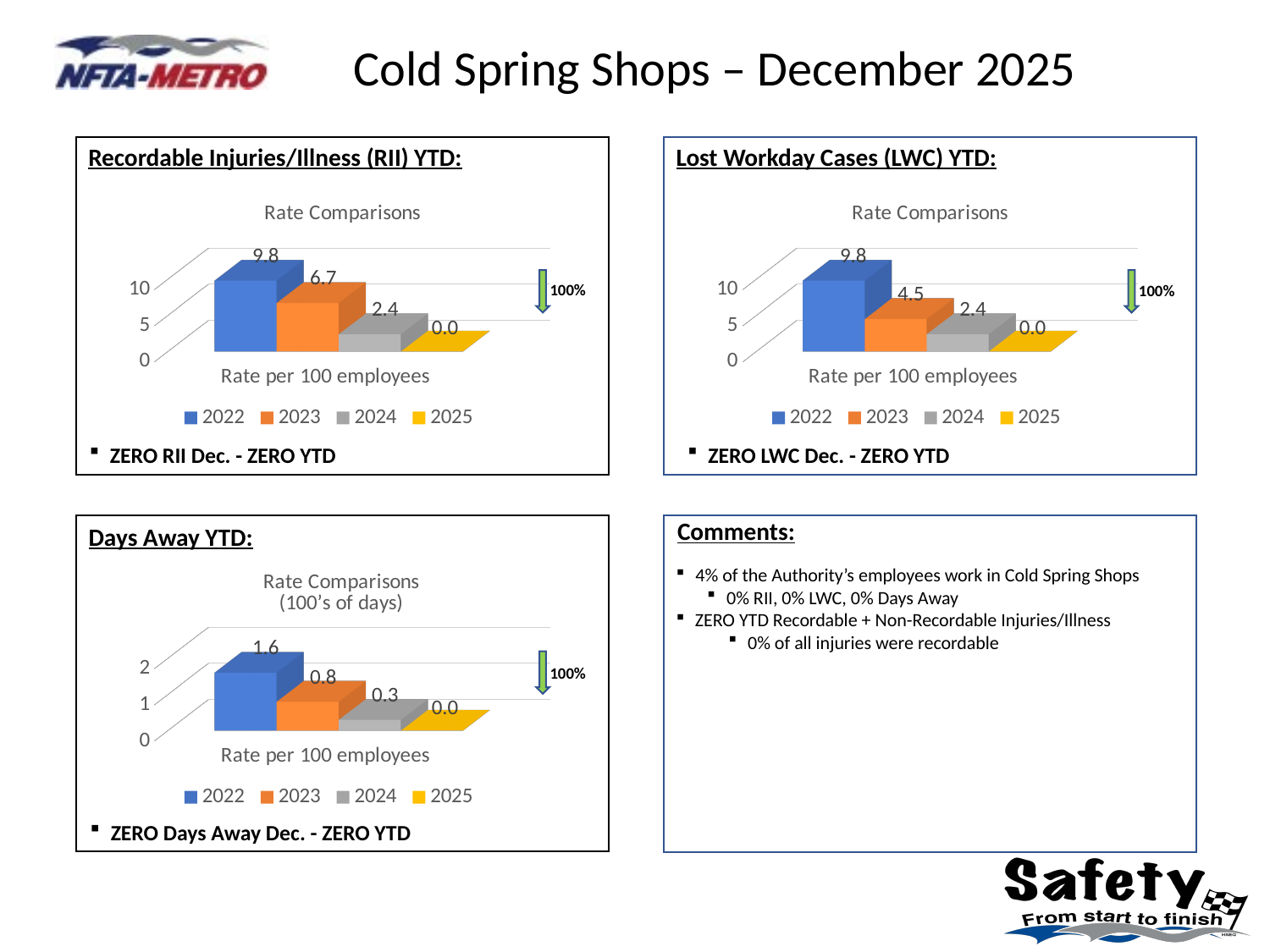
In the Lost Workday Cases (LWC) YTD chart, which year has the lowest value? 2025 In the Recordable Injuries/Illness (RII) YTD chart, what is the value for 2023? 6.7 In the Lost Workday Cases (LWC) YTD chart, what is the value for 2023? 4.5 How many series does the legend list in the Lost Workday Cases (LWC) YTD chart? 4 In the Lost Workday Cases (LWC) YTD chart, what is the difference between the 2023 and 2024 values? 2.1 What kind of chart is shown in the Days Away YTD box? Bar chart In the Days Away YTD chart, what is the value for 2024? 0.3 In the Days Away YTD chart, which is larger, the value for 2023 or the value for 2024? 2023 In the Recordable Injuries/Illness (RII) YTD chart, which year has the highest value? 2022 In the Days Away YTD chart, what is the value for 2022? 1.6 In the Recordable Injuries/Illness (RII) YTD chart, do the values rise or fall from 2022 to 2025? Fall In the Recordable Injuries/Illness (RII) YTD chart, what is the difference between the 2022 and 2023 values? 3.1